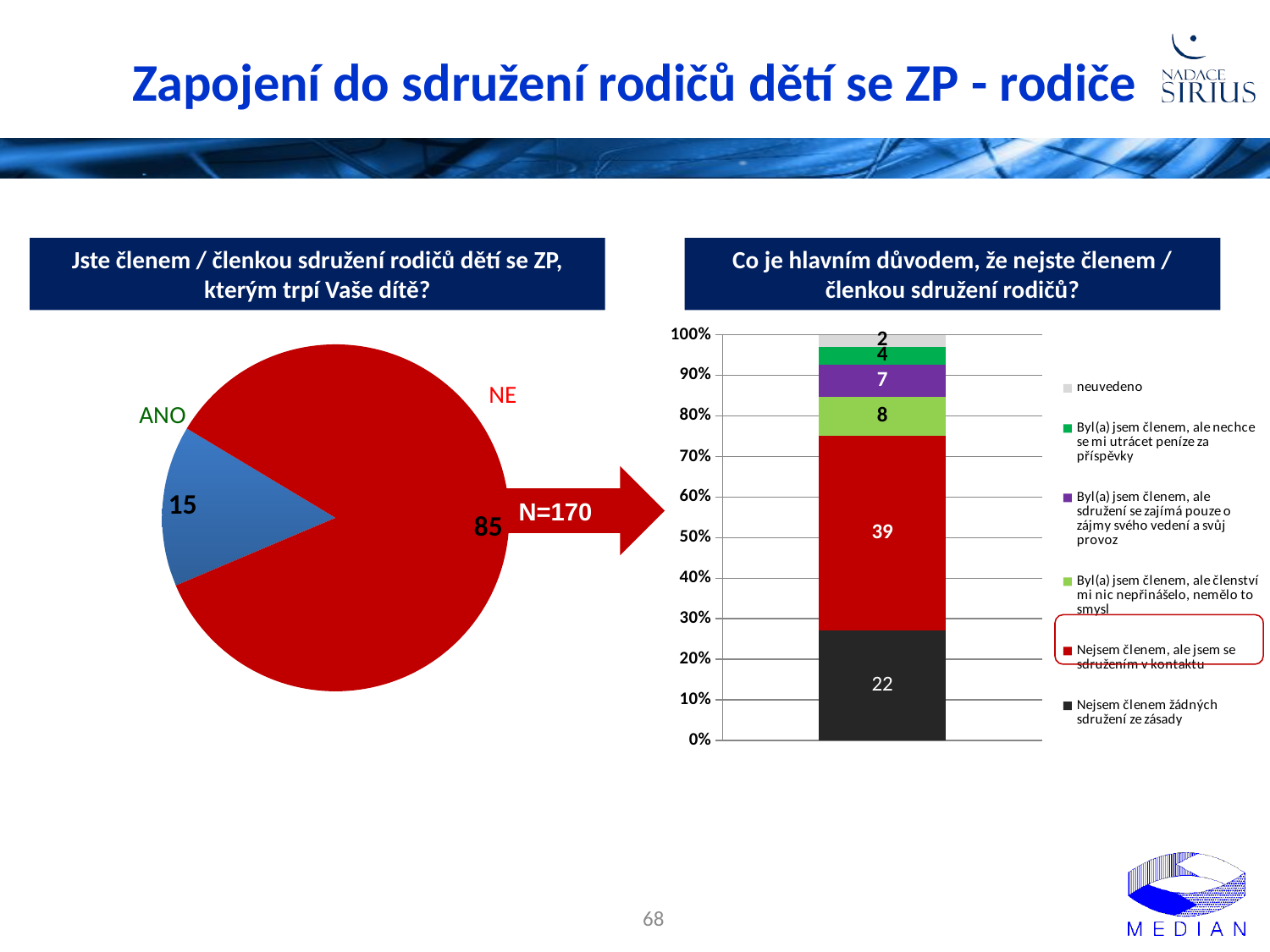
In the pie chart on the left, what is the difference between the NE and ANO values? 70 In the stacked bar chart on the right, what is the value for 'neuvedeno'? 2 In the stacked bar chart on the right, what is the total of all segments in the bar? 82 In the stacked bar chart on the right, what is the value for 'Nejsem členem žádných sdružení ze zásady'? 22 In the stacked bar chart on the right, how many series does the legend list? 6 In the pie chart on the left, which slice is larger, ANO or NE? NE In the pie chart on the left, what is the value for NE? 85 What type of chart is shown on the left side of the slide? pie chart In the stacked bar chart on the right, what is the value for 'Nejsem členem, ale jsem se sdružením v kontaktu'? 39 In the pie chart on the left, how many slices are there? 2 In the pie chart on the left, what is the value for ANO? 15 In the stacked bar chart on the right, which category has the highest value? Nejsem členem, ale jsem se sdružením v kontaktu